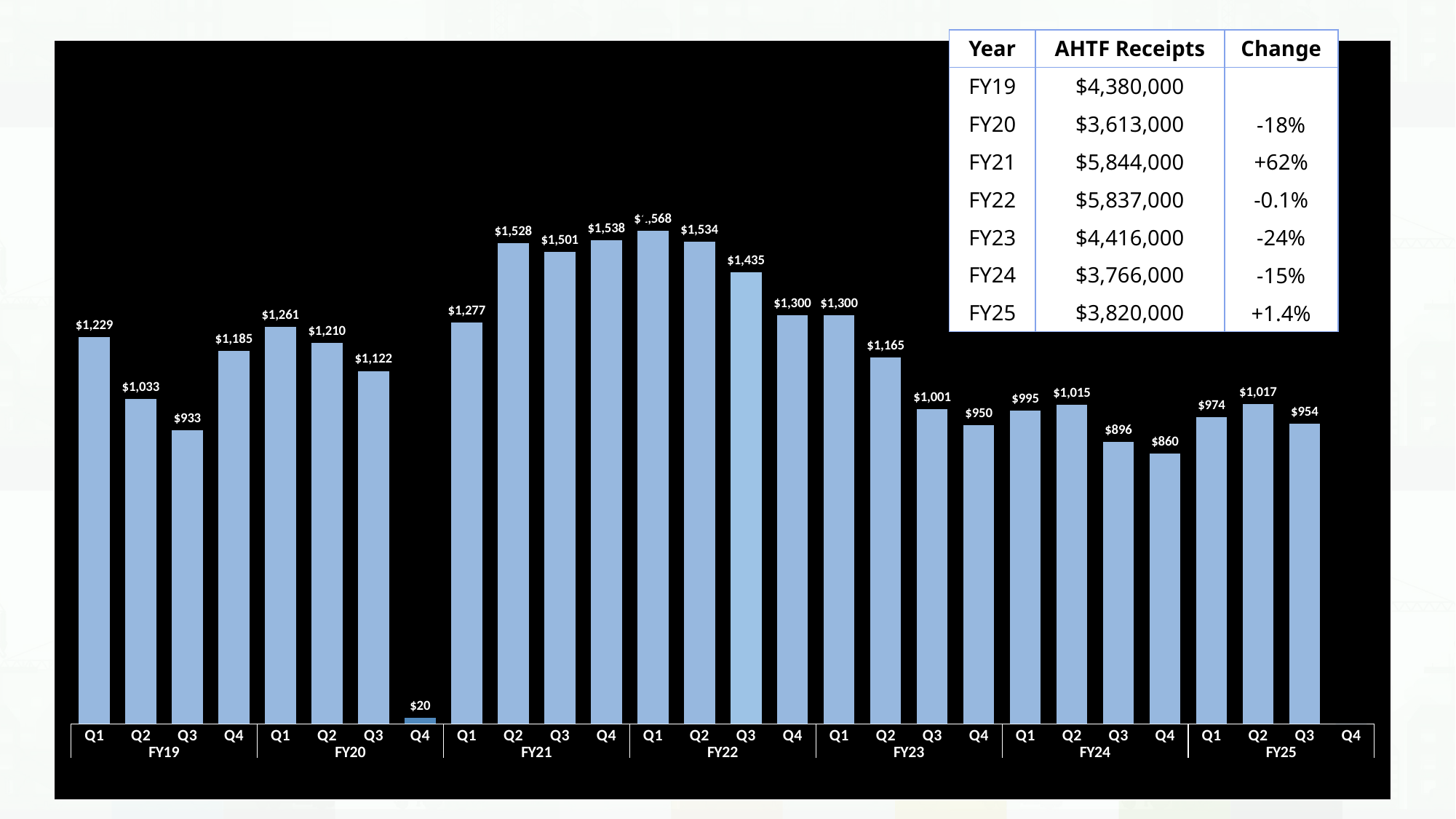
Which is larger, Q2 FY24 or Q1 FY25? Q2 FY24 Do the values rise or fall from Q1 FY23 to Q4 FY23? Fall What is the value for Q3 of FY24? $896 What is the difference between Q1 FY20 and Q2 FY20? $51 Which is larger, Q3 FY19 or Q3 FY23? Q3 FY23 What kind of chart is shown on the slide? Bar chart What is the value for Q1 of FY19? $1,229 In the table, what is the AHTF Receipts value for FY21? $5,844,000 What is the value for Q4 of FY21? $1,538 What is the value for Q2 of FY25? $1,017 Which quarter has the lowest value in the chart? Q4 FY20 What is the difference between Q3 FY22 and Q4 FY22? $135